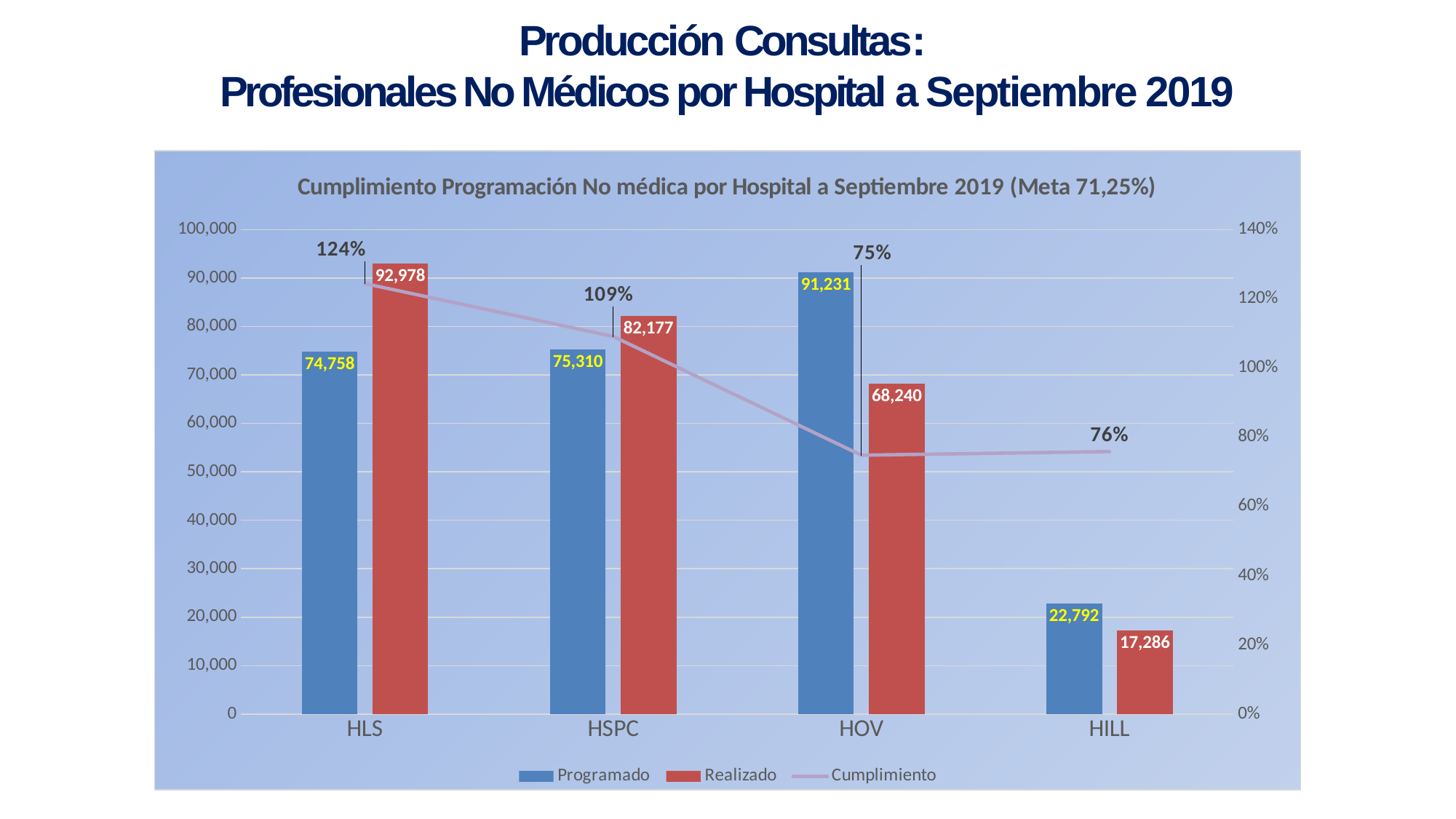
Which hospital has the highest Realizado value? HLS For HILL, which is larger: the Programado value or the Realizado value? Programado How many hospitals are shown on the x axis? 4 What type of chart is used to show the Programado and Realizado values? Bar chart What is the target (Meta) percentage stated in the chart title? 71,25% What is the difference between the Realizado and Programado values for HLS? 18,220 What is the Cumplimiento percentage for HSPC? 109% Which hospital has the lowest Programado value? HILL What is the Programado value for HOV? 91,231 How many series does the legend list? 3 What is the Realizado value for HLS? 92,978 By how much does the Programado value exceed the Realizado value for HOV? 22,991